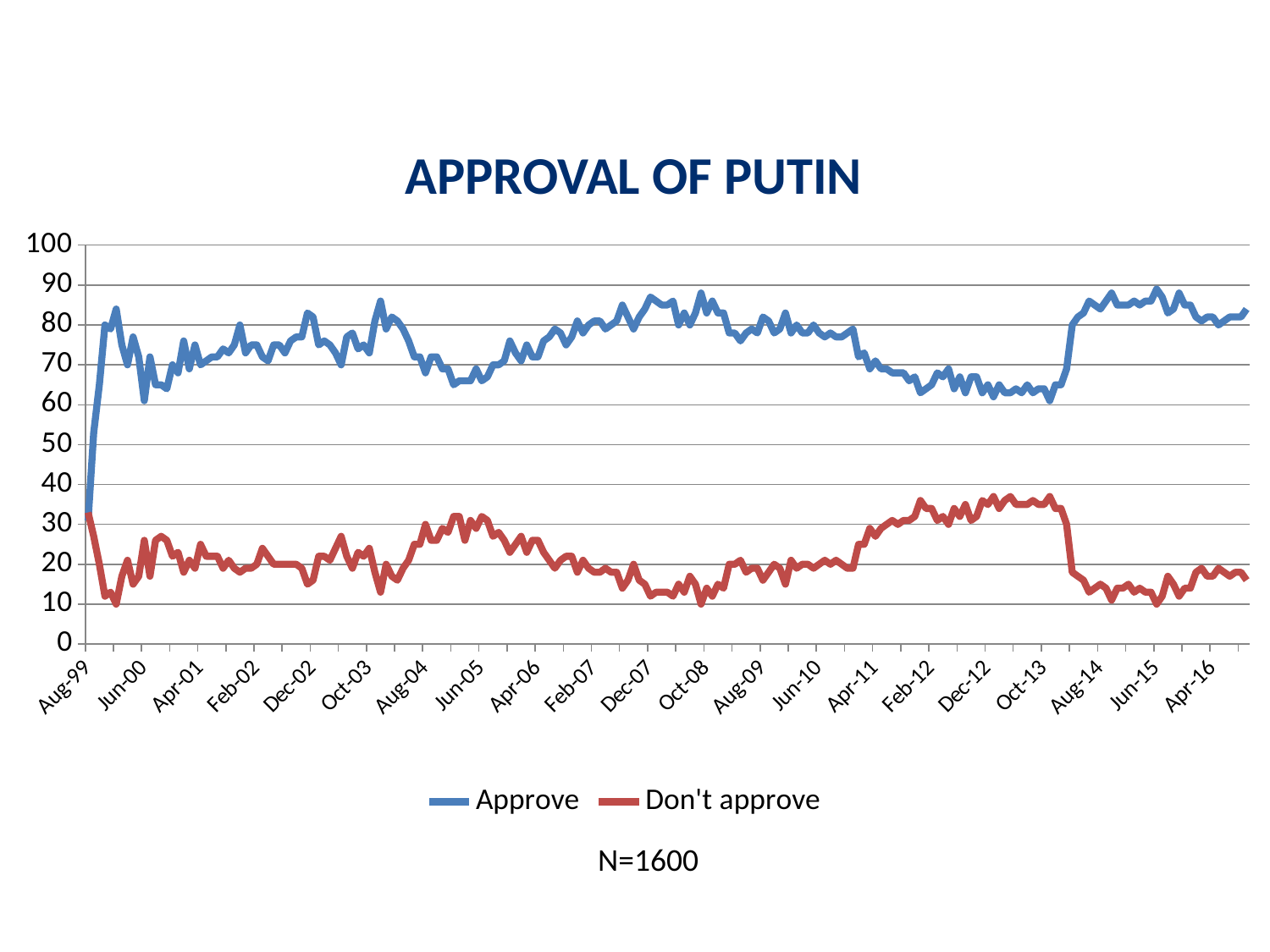
Does the Don't approve line rise or fall between Oct-13 and Aug-14? fall Is the Don't approve value around Oct-13 greater or less than 30? greater What sample size is noted below the chart? N=1600 What kind of chart is shown on the slide? line chart Does the Approve line rise or fall between Oct-13 and Aug-14? rise How many series does the legend list? 2 Is the Don't approve value around Oct-08 greater or less than 20? less Is the Approve value around Jun-15 greater or less than 80? greater Which series is higher around Jun-15, Approve or Don't approve? Approve What is the title of the chart? APPROVAL OF PUTIN